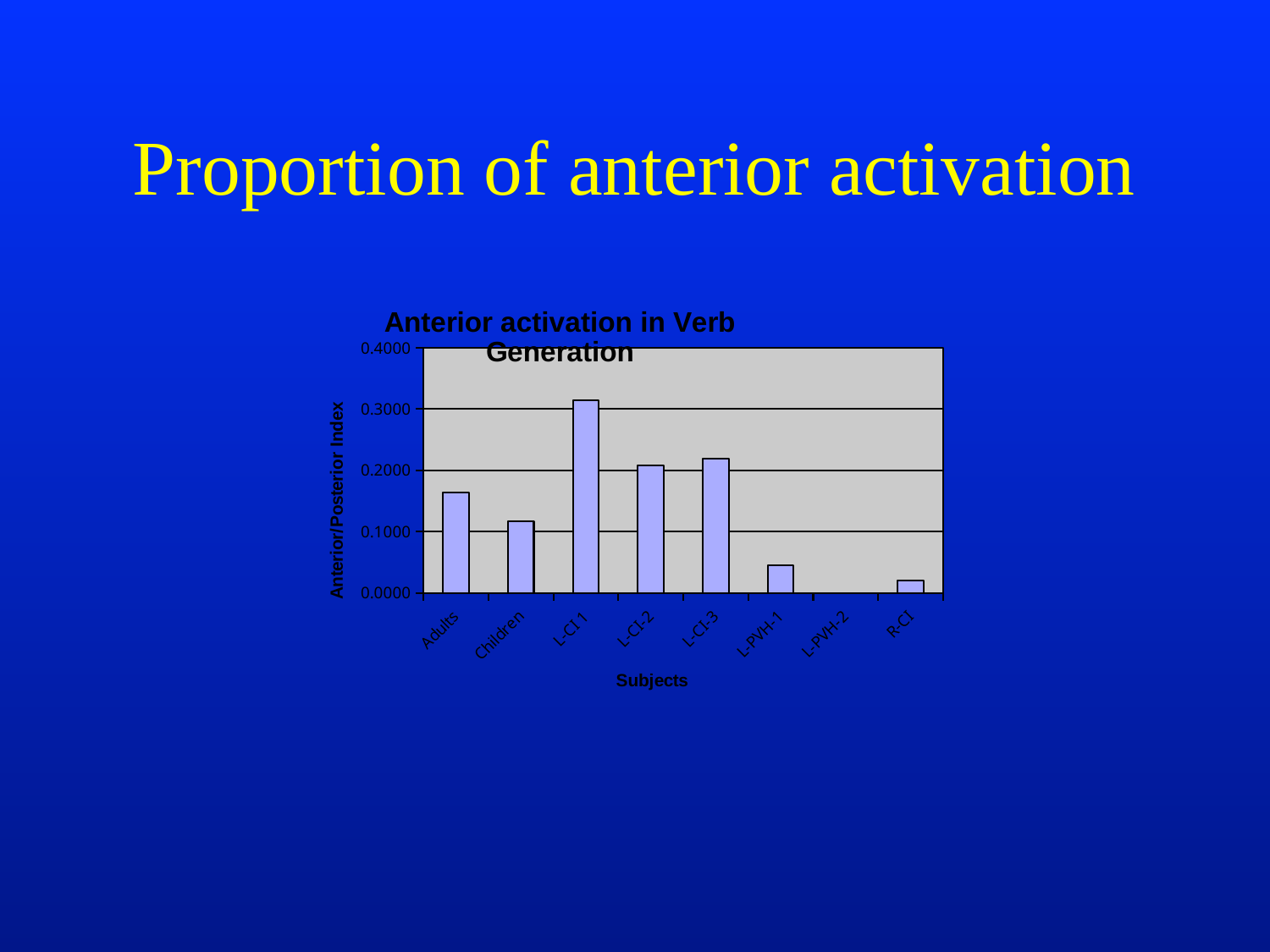
What kind of chart is shown on the slide? bar chart How many subject categories are plotted on the x axis? 8 What is the title of the chart? Anterior activation in Verb Generation Which has the larger Anterior/Posterior Index, L-CI 1 or L-CI-3? L-CI 1 What is the label on the y axis of the chart? Anterior/Posterior Index Which subject has the highest Anterior/Posterior Index? L-CI 1 Which has the larger Anterior/Posterior Index, Adults or Children? Adults Is the value for L-PVH-1 greater or less than 0.1000? less Is the value for L-CI 1 greater or less than 0.2000? greater Which subject has the lowest Anterior/Posterior Index? L-PVH-2 Is the value for Children greater or less than 0.2000? less